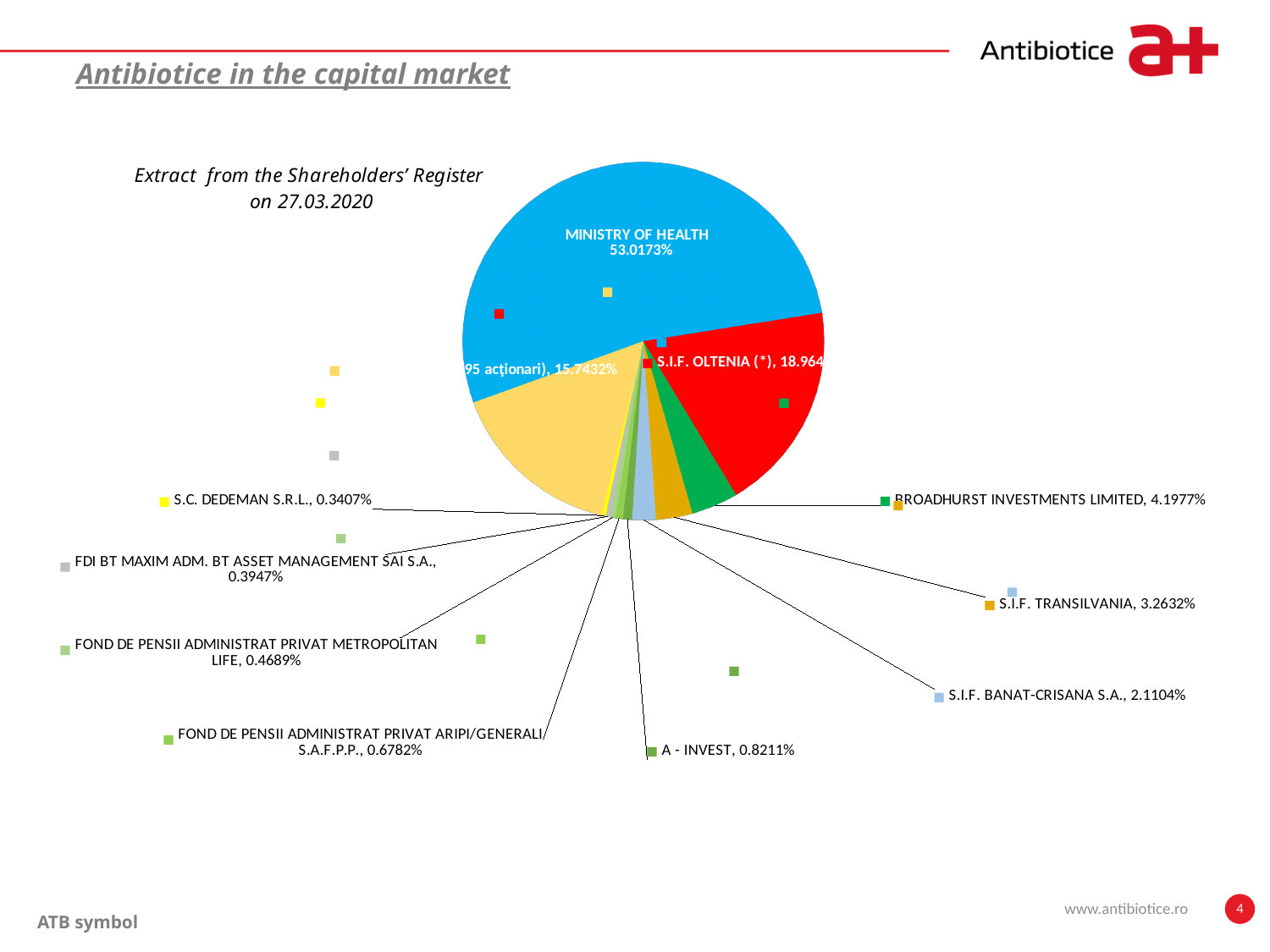
What is the value shown for S.C. DEDEMAN S.R.L.? 0.3407% Which is larger, the value for S.I.F. TRANSILVANIA or the value for S.I.F. BANAT-CRISANA S.A.? S.I.F. TRANSILVANIA What is the value shown for A - INVEST? 0.8211% What is the value shown for S.I.F. BANAT-CRISANA S.A.? 2.1104% What is the value shown for FOND DE PENSII ADMINISTRAT PRIVAT METROPOLITAN LIFE? 0.4689% What kind of chart is shown on the slide? pie chart Which labelled shareholder has the smallest value? S.C. DEDEMAN S.R.L. What is the difference between the values for BROADHURST INVESTMENTS LIMITED and S.I.F. TRANSILVANIA? 0.9345% What is the value shown for S.I.F. TRANSILVANIA? 3.2632% Which shareholder has the largest slice of the pie? MINISTRY OF HEALTH What is the value shown for BROADHURST INVESTMENTS LIMITED? 4.1977% What share of the pie does MINISTRY OF HEALTH hold? 53.0173%